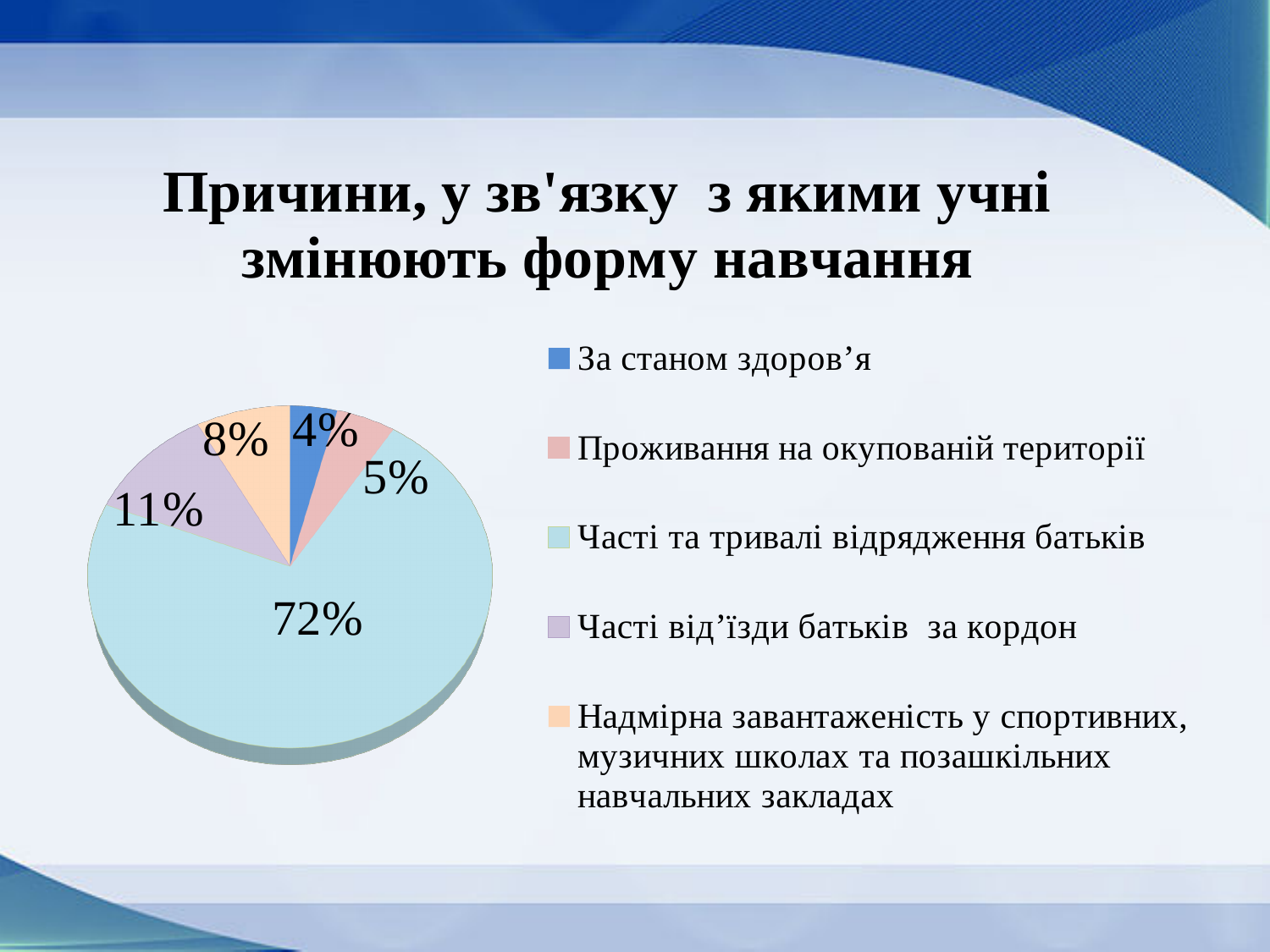
What share of the pie is labelled for "Проживання на окупованій території"? 5% Which slice is larger: "Проживання на окупованій території" or "Часті від’їзди батьків за кордон"? Часті від’їзди батьків за кордон What is the difference in percentage points between the slices for "Часті від’їзди батьків за кордон" and "Надмірна завантаженість у спортивних, музичних школах та позашкільних навчальних закладах"? 3% What kind of chart is shown on the slide? Pie chart What share of the pie is labelled for "Надмірна завантаженість у спортивних, музичних школах та позашкільних навчальних закладах"? 8% Which category has the smallest slice of the pie? За станом здоров’я What share of the pie is labelled for "Часті від’їзди батьків за кордон"? 11% How many categories does the legend of the pie chart list? 5 Which category has the largest slice of the pie? Часті та тривалі відрядження батьків What is the title of the slide containing the pie chart? Причини, у зв'язку з якими учні змінюють форму навчання